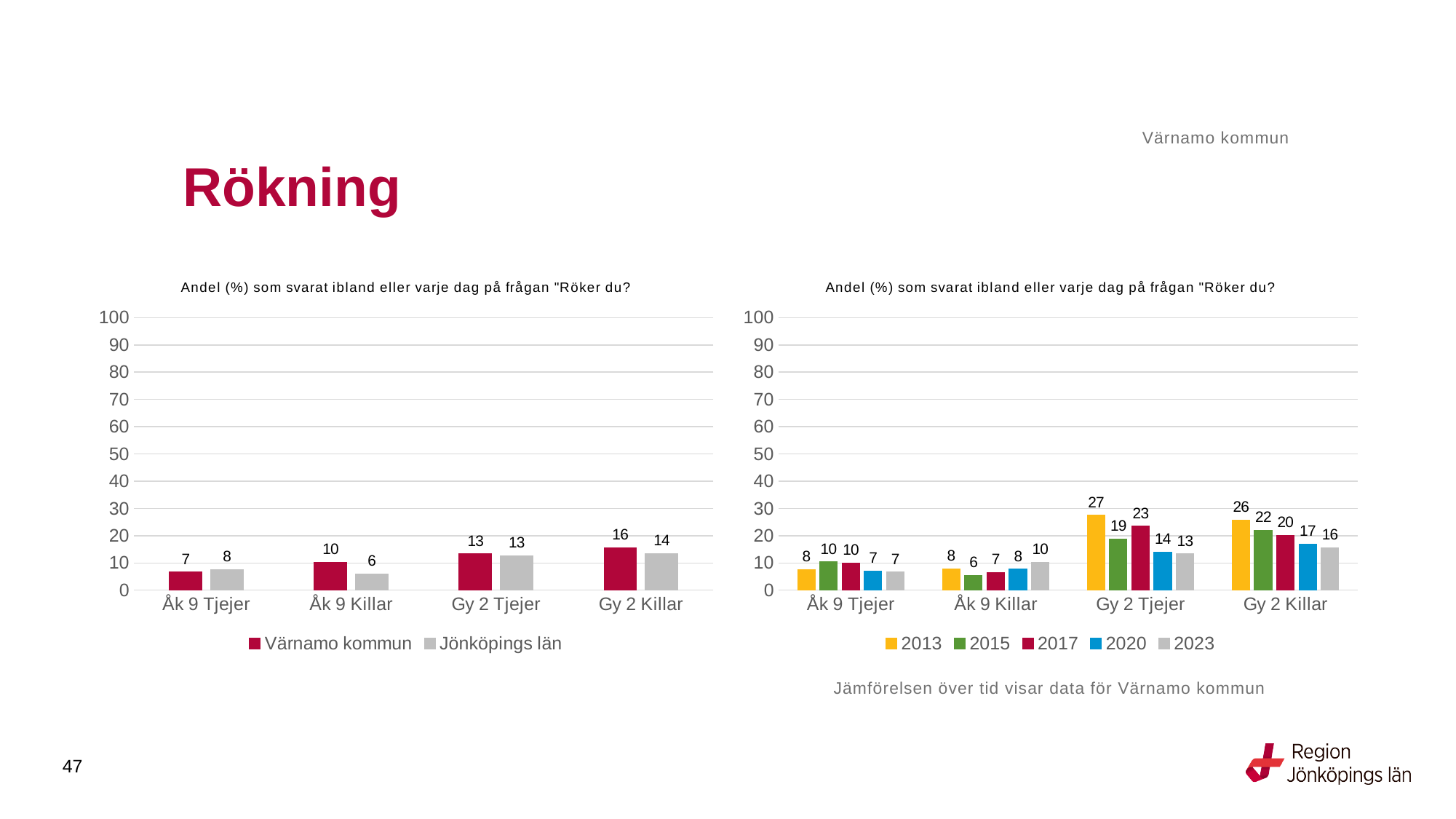
In the left chart, which category has the highest value for Värnamo kommun? Gy 2 Killar In the left chart, how many series does the legend list? 2 In the right chart, what is the value for 2013 for Gy 2 Tjejer? 27 What kind of chart is the left chart? bar chart In the right chart, which year has the lowest value for Gy 2 Killar? 2023 In the left chart, what is the value for Jönköpings län for Åk 9 Killar? 6 In the right chart, which is larger for Gy 2 Tjejer: the value for 2015 or the value for 2017? 2017 In the right chart, how many series does the legend list? 5 In the left chart, what is the value for Värnamo kommun for Gy 2 Killar? 16 In the right chart, do the values for Gy 2 Killar rise or fall from 2013 to 2023? fall In the left chart, what is the difference between Värnamo kommun and Jönköpings län for Åk 9 Killar? 4 In the right chart, what is the value for 2023 for Åk 9 Killar? 10